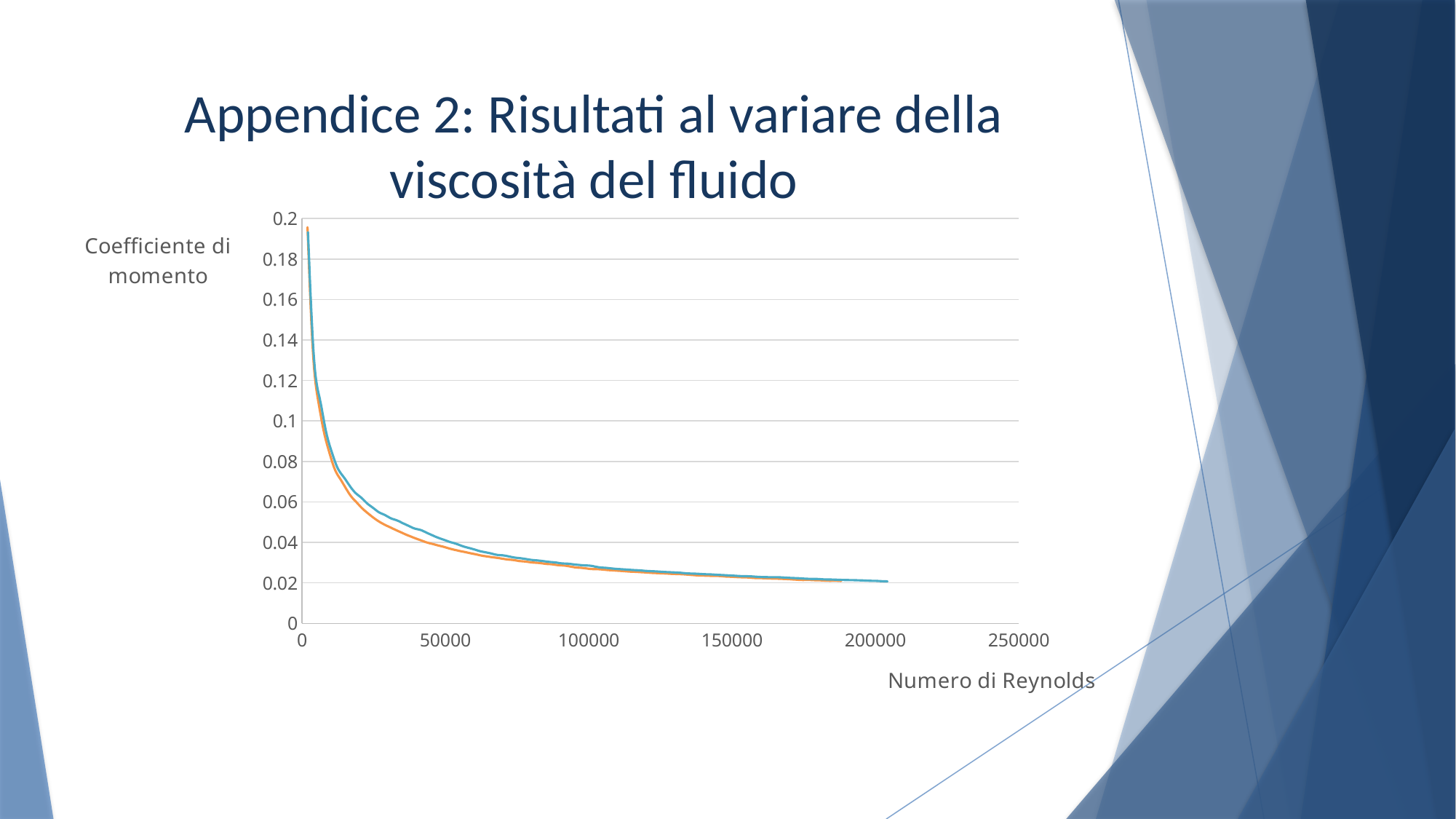
Do the plotted values rise or fall as the Numero di Reynolds increases? fall How many lines are plotted on the chart? 2 What is the title of the slide containing the chart? Appendice 2: Risultati al variare della viscosità del fluido What is the label of the horizontal axis of the chart? Numero di Reynolds At a Numero di Reynolds of 50000, which line has the higher Coefficiente di momento, the blue line or the orange line? the blue line What kind of chart is shown on the slide? line chart Is the value of the lines at a Numero di Reynolds of 100000 greater or less than 0.04? less Is the value of the lines at a Numero di Reynolds of 50000 greater or less than 0.06? less Is the value of the lines at a Numero di Reynolds of 150000 greater or less than 0.02? greater What is the highest tick value shown on the vertical axis of the chart? 0.2 Which line extends to a higher Numero di Reynolds, the blue line or the orange line? the blue line